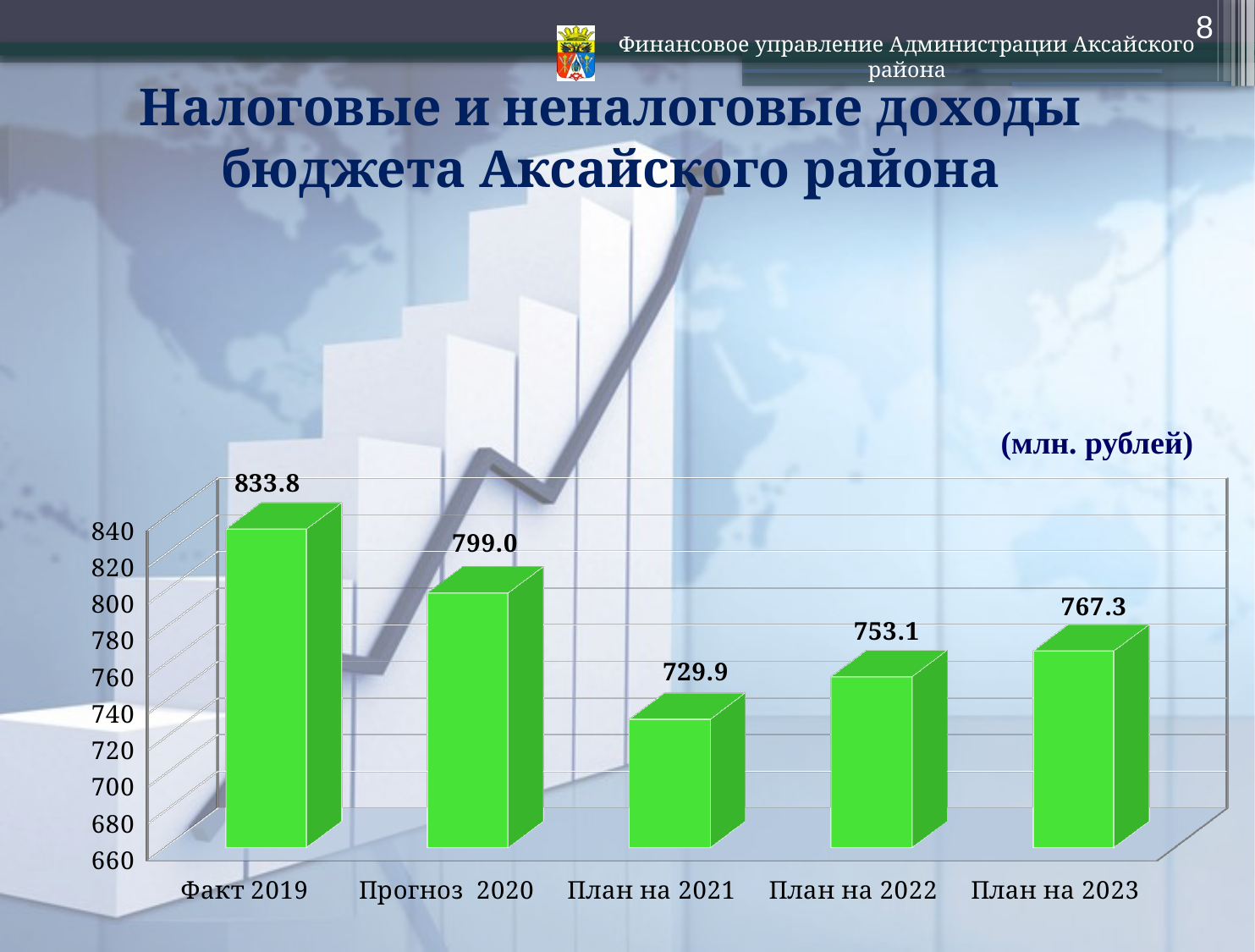
Is the value for План на 2021 greater or less than 740? less What kind of chart is shown on the slide? bar chart What is the difference between the values for План на 2023 and План на 2021? 37.4 What is the value for План на 2023? 767.3 How many categories are shown on the x axis? 5 In what units are the values on the chart expressed? млн. рублей Which category has the lowest value? План на 2021 What is the difference between the values for Факт 2019 and Прогноз 2020? 34.8 Which is larger, the value for Прогноз 2020 or the value for План на 2022? Прогноз 2020 Which category has the highest value? Факт 2019 What is the value for Факт 2019? 833.8 What is the value for План на 2022? 753.1